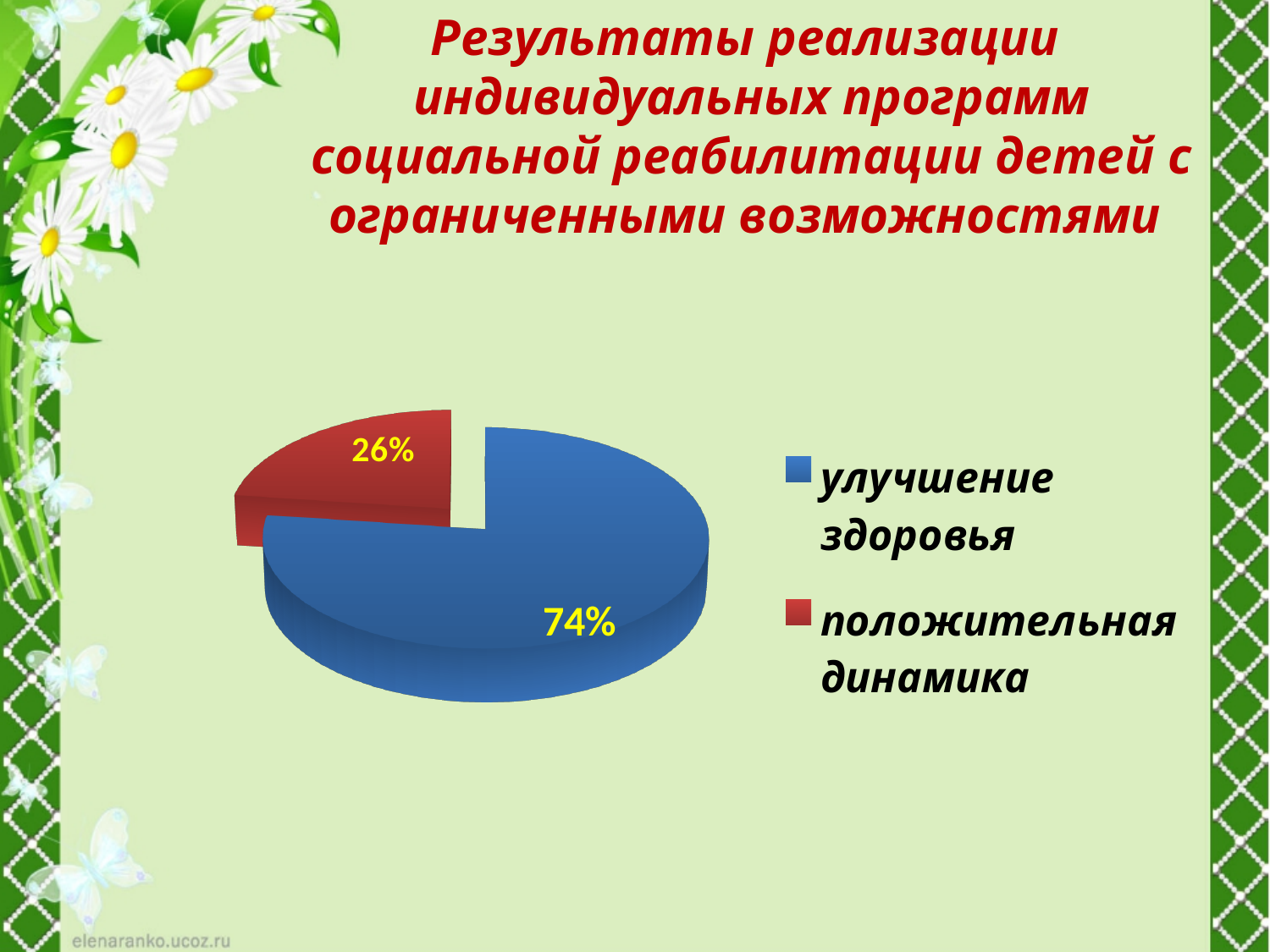
What share of the pie does "улучшение здоровья" represent? 74% What is the difference in percentage points between "улучшение здоровья" and "положительная динамика"? 48 What colour is the slice for "улучшение здоровья"? blue Which category has the largest slice of the pie? улучшение здоровья How many slices does the pie chart have? 2 How many entries does the legend list? 2 What kind of chart is shown on the slide? pie chart Which category has the smallest slice of the pie? положительная динамика Which is larger: the slice for "улучшение здоровья" or the slice for "положительная динамика"? улучшение здоровья What share of the pie does "положительная динамика" represent? 26% What colour is the slice for "положительная динамика"? red